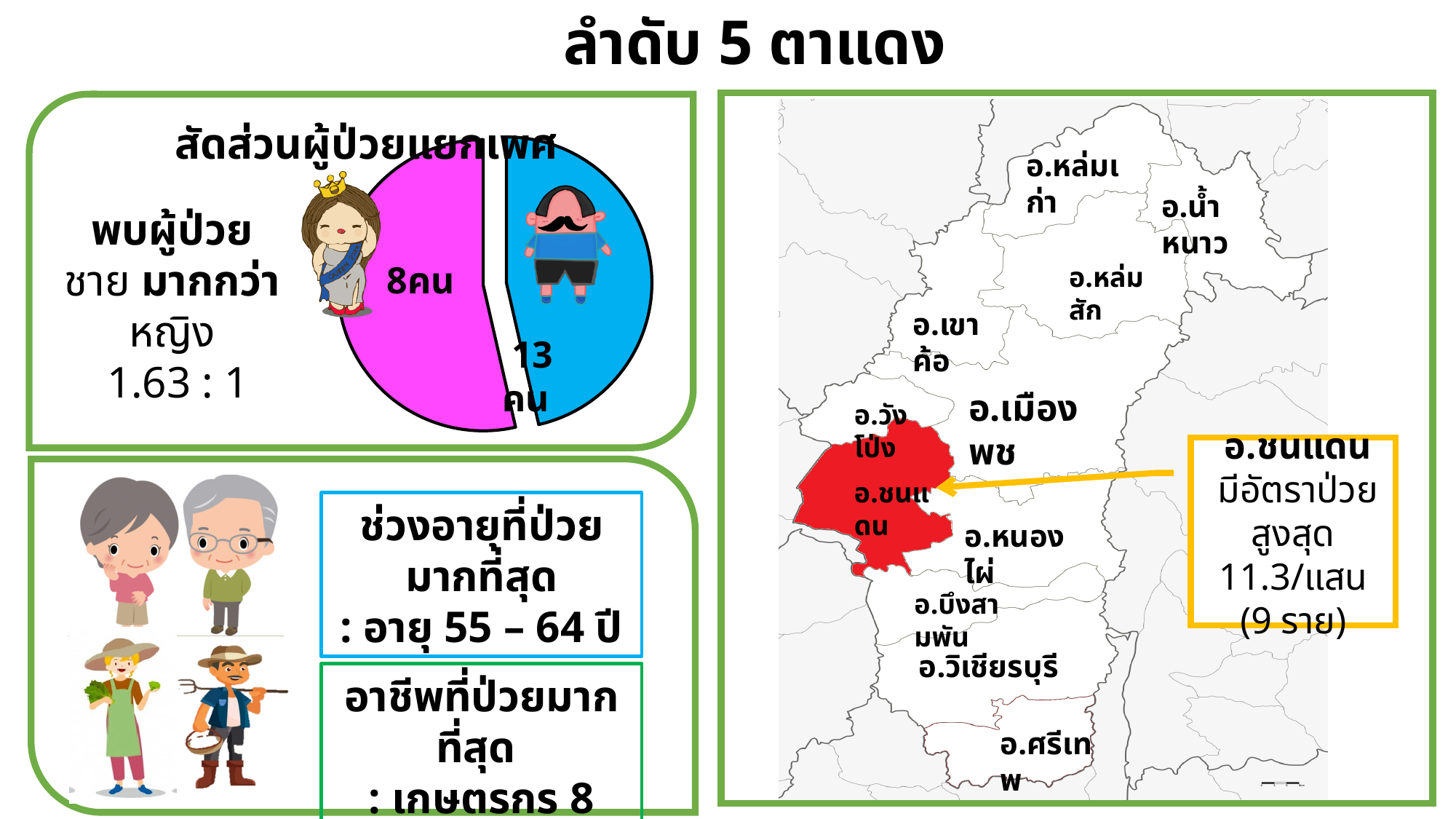
What is the total number of patients represented by the two slices of the pie chart? 21 What colour is the slice representing male patients in the pie chart? blue What is the difference between the male and female patient counts shown in the pie chart? 5 What type of chart is shown in the top-left panel of the slide? pie chart How many slices does the pie chart have? 2 In the pie chart, what value is printed on the pink (female) slice? 8คน What male-to-female ratio is stated next to the pie chart? 1.63 : 1 According to the printed labels, which group has the higher number of patients in the pie chart, male or female? male (13 คน) According to the printed labels, which group has the lower number of patients in the pie chart? female (8คน) In the pie chart, what value is printed on the blue (male) slice? 13 คน What is the title of the pie chart? สัดส่วนผู้ป่วยแยกเพศ